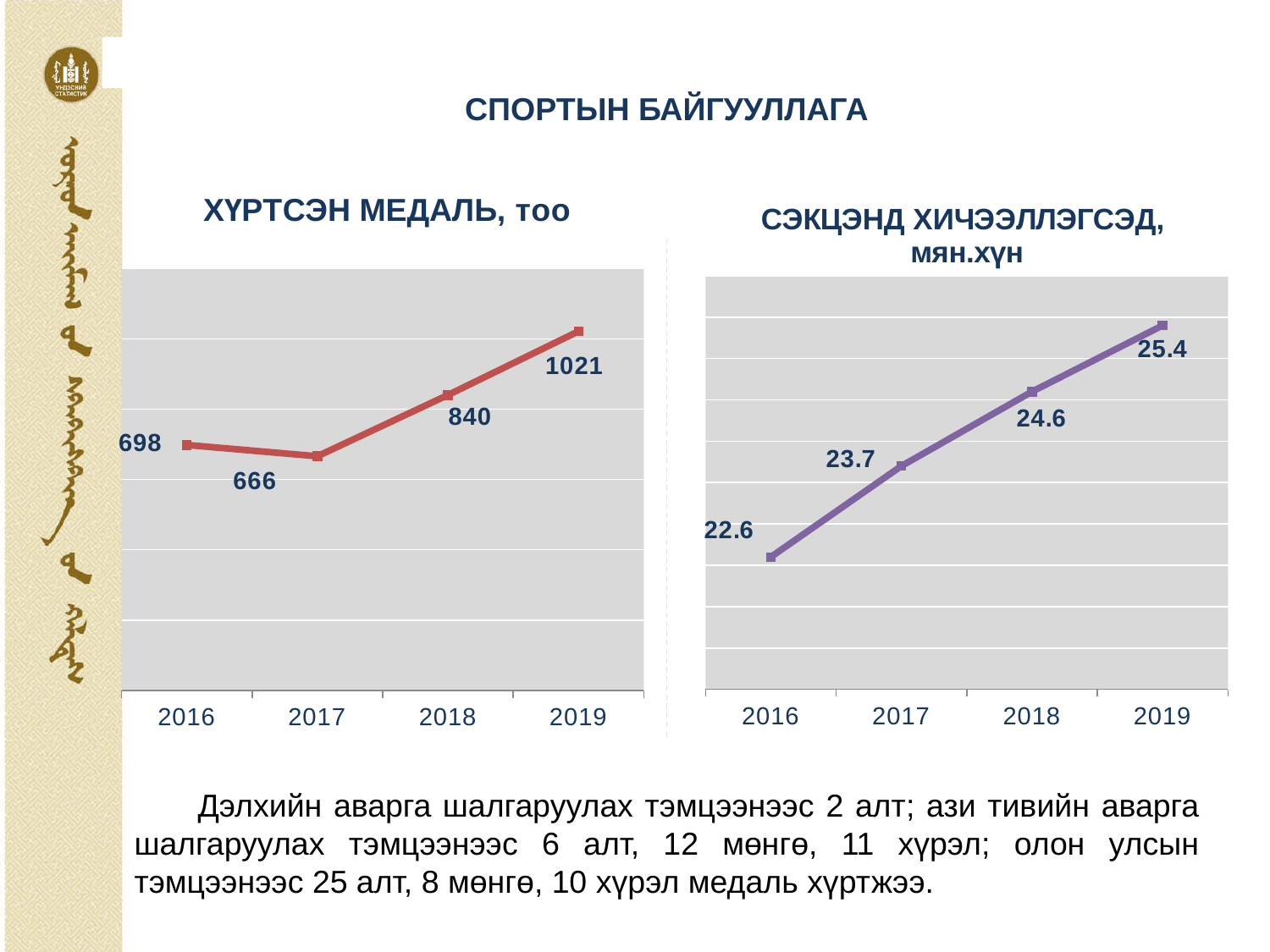
In the chart titled "ХҮРТСЭН МЕДАЛЬ, тоо", what is the value for 2019? 1021 How many years are plotted in the chart titled "СЭКЦЭНД ХИЧЭЭЛЛЭГСЭД, мян.хүн"? 4 In the chart titled "ХҮРТСЭН МЕДАЛЬ, тоо", which is larger, the value for 2016 or the value for 2017? 2016 In the chart titled "ХҮРТСЭН МЕДАЛЬ, тоо", which year has the lowest value? 2017 In the chart titled "СЭКЦЭНД ХИЧЭЭЛЛЭГСЭД, мян.хүн", what is the value for 2016? 22.6 In the chart titled "СЭКЦЭНД ХИЧЭЭЛЛЭГСЭД, мян.хүн", do the values rise or fall from 2016 to 2019? rise What kind of chart is the chart titled "ХҮРТСЭН МЕДАЛЬ, тоо"? line chart In the chart titled "ХҮРТСЭН МЕДАЛЬ, тоо", which year has the highest value? 2019 In the chart titled "СЭКЦЭНД ХИЧЭЭЛЛЭГСЭД, мян.хүн", what is the value for 2018? 24.6 In the chart titled "ХҮРТСЭН МЕДАЛЬ, тоо", what is the value for 2017? 666 In the chart titled "СЭКЦЭНД ХИЧЭЭЛЛЭГСЭД, мян.хүн", what is the difference between the values for 2019 and 2016? 2.8 In the chart titled "ХҮРТСЭН МЕДАЛЬ, тоо", what is the difference between the values for 2019 and 2018? 181